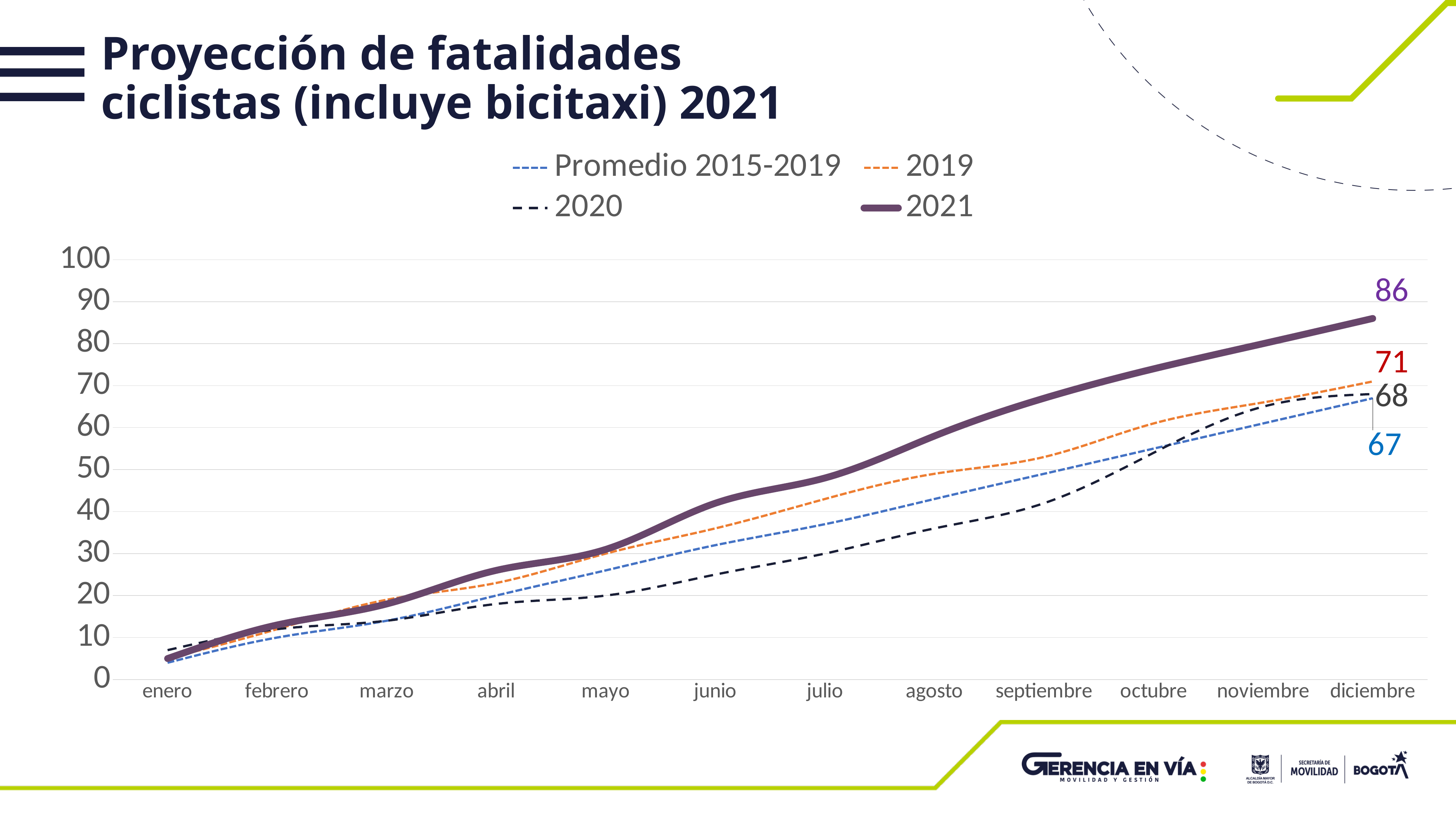
What kind of chart is shown on the slide? line chart How many months are shown along the x axis? 12 What is the value of the 2021 series in diciembre? 86 Is the value of the 2021 series in agosto greater or less than 50? greater What is the value of the 2019 series in diciembre? 71 In diciembre, which is larger: the 2020 value or the Promedio 2015-2019 value? 2020 What is the value of the 2020 series in diciembre? 68 What is the value of the Promedio 2015-2019 series in diciembre? 67 What is the difference between the 2021 and 2019 values in diciembre? 15 Does the 2021 series rise or fall from enero to diciembre? rise How many series does the legend list? 4 Which series has the highest value in diciembre? 2021